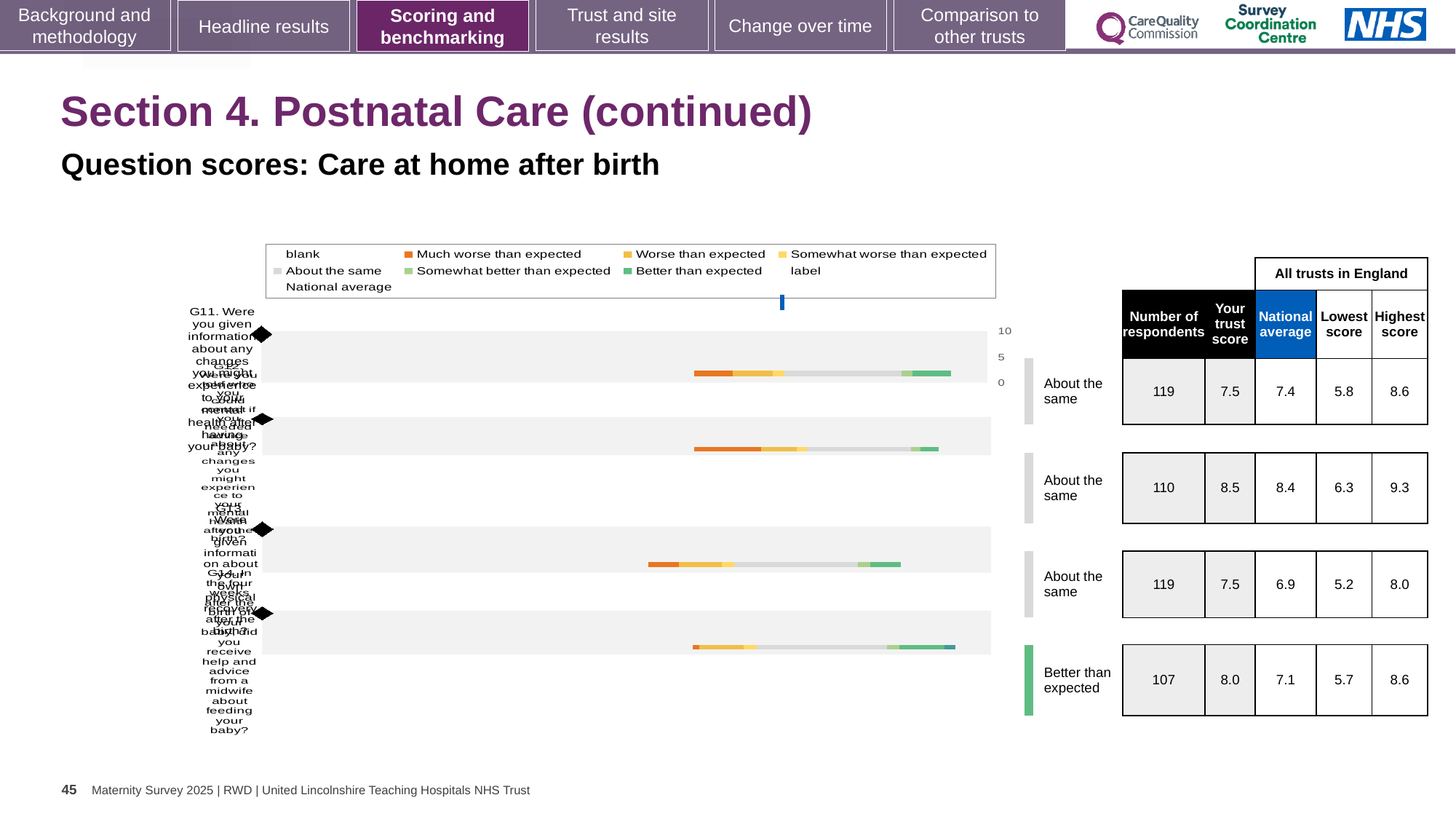
What is the lowest score for the fourth (bottom) question row? 5.7 What kind of chart is shown on the slide? bar chart Which question row has the highest trust score? the second row (8.5) Which question row is rated 'Better than expected'? the fourth (bottom) row For the fourth (bottom) question row, which is larger: the trust score or the national average? the trust score (8.0) Which question row has the lowest national average? the third row (6.9) How many question rows are plotted in the chart? 4 What is the trust score for the second question row? 8.5 What is the national average for the third question row? 6.9 For the third question row, what is the difference between the trust score and the national average? 0.6 What is the highest score for the second question row? 9.3 What is the number of respondents for the first (top) question row? 119